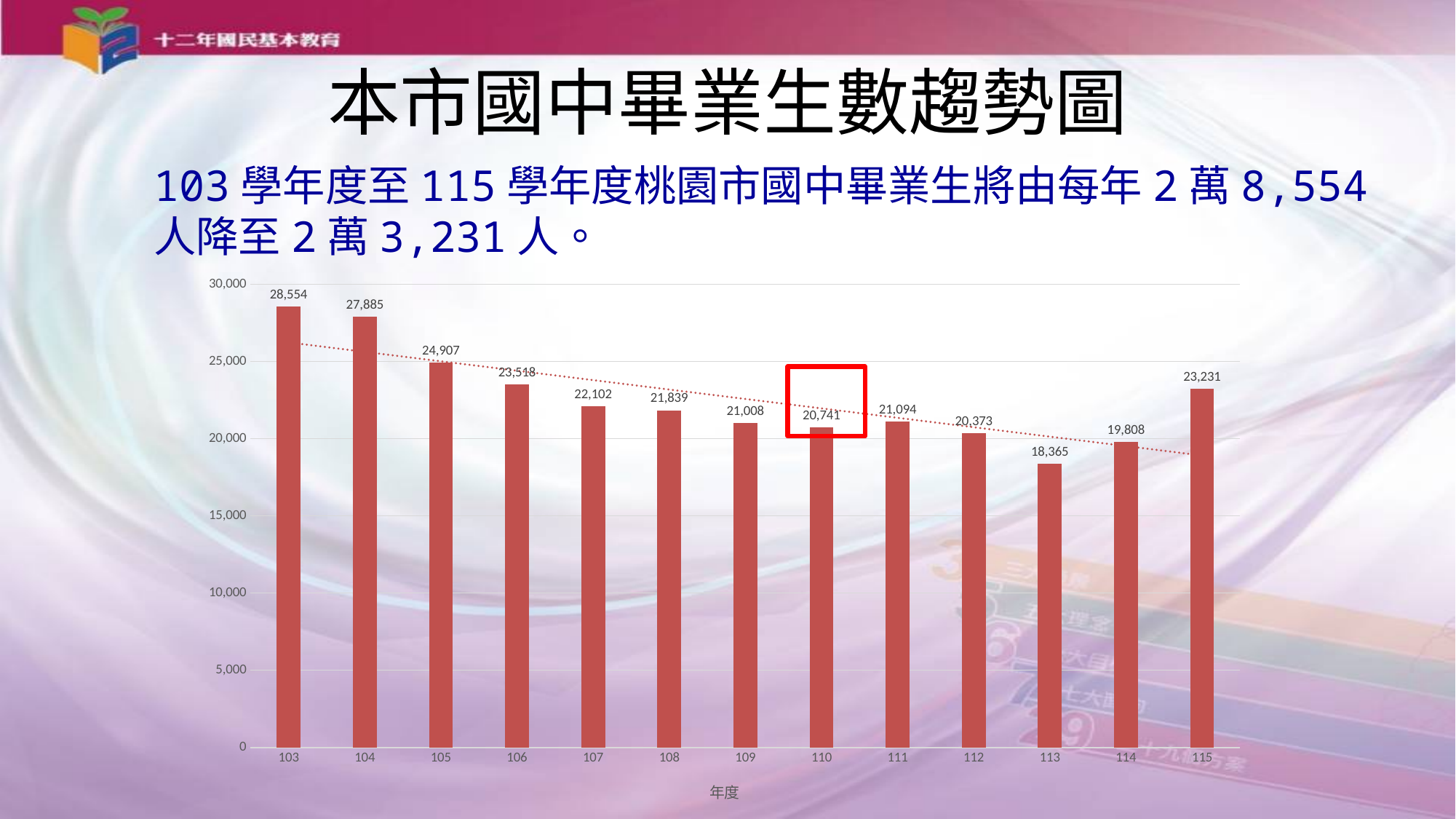
Which is larger, the value for year 111 or the value for year 112? 111 What is the difference between the values for year 103 and year 115? 5,323 Do the values generally rise or fall from year 103 to year 113? fall What is the value for year 110? 20,741 What kind of chart is this? bar chart How many years are shown on the x axis? 13 What is the label of the x axis? 年度 Which year has the lowest value? 113 What is the value for year 103? 28,554 Which year has the highest value? 103 Is the value for year 113 greater or less than 20,000? less What is the value for year 115? 23,231